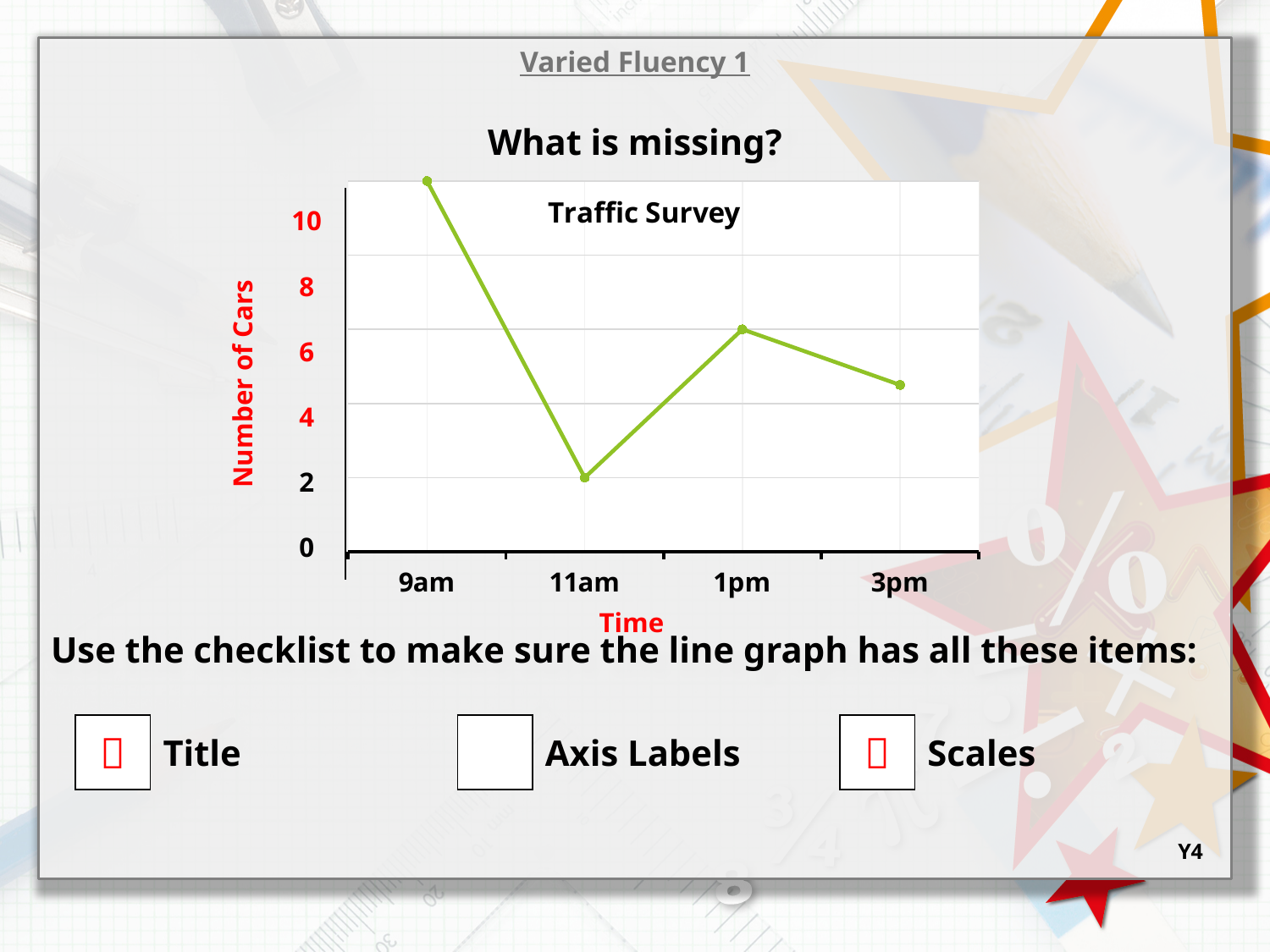
What is the label on the vertical axis of the chart? Number of Cars What is the number of cars at 11am? 2 Is the number of cars at 3pm greater or less than 6? less At which time is the number of cars lowest? 11am At which time is the number of cars highest? 9am What is the title of the chart? Traffic Survey Which has more cars, 1pm or 3pm? 1pm How many time points are plotted on the Traffic Survey chart? 4 Does the number of cars rise or fall from 9am to 11am? fall What kind of chart is shown on the slide? line chart